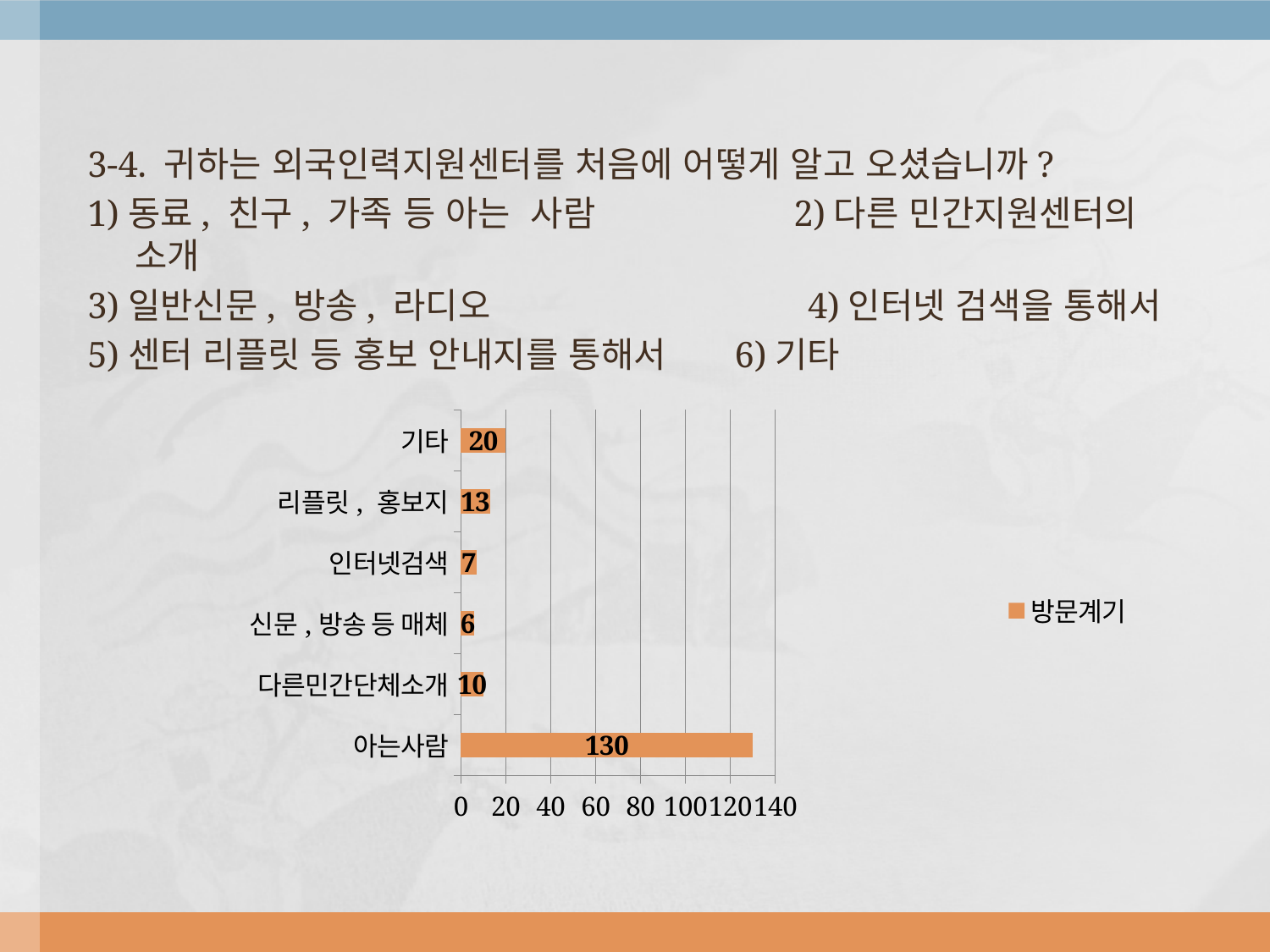
What is the value for 리플릿, 홍보지? 13 Which category has the highest value? 아는사람 What is the value for 아는사람? 130 Which category has the lowest value? 신문, 방송 등 매체 Which is larger, the value for 인터넷검색 or the value for 다른민간단체소개? 다른민간단체소개 How many categories are shown in the chart? 6 What is the difference between the values for 아는사람 and 기타? 110 Is the value for 아는사람 greater or less than 100? greater What kind of chart is shown on the slide? bar chart What is the value for 기타? 20 What is the value for 신문, 방송 등 매체? 6 What series name does the legend show? 방문계기